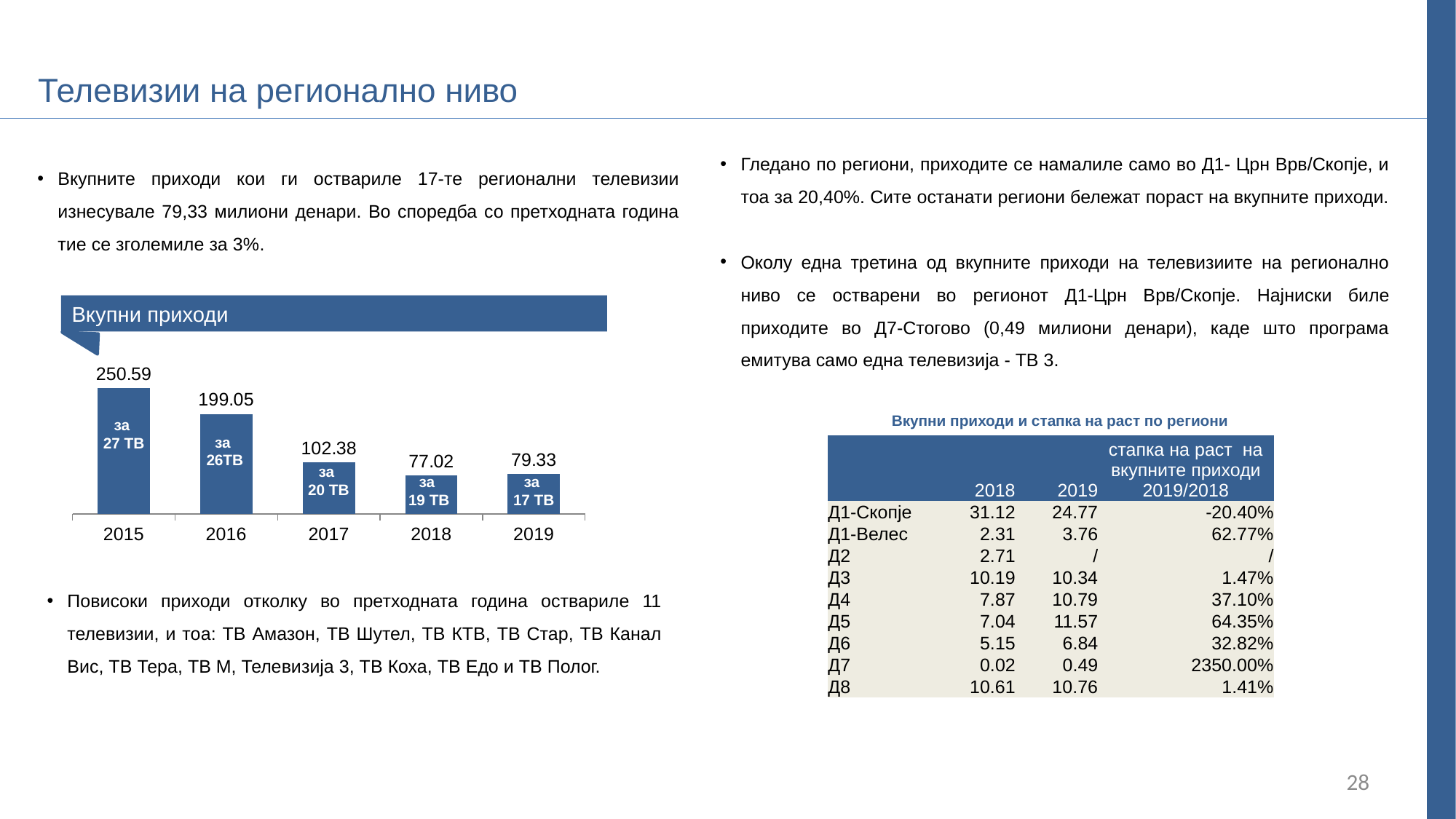
What is the value for 2017 in the 'Вкупни приходи' chart? 102.38 Which year has the highest value in the 'Вкупни приходи' chart? 2015 What is the value for 2015 in the 'Вкупни приходи' chart? 250.59 Do the values in the 'Вкупни приходи' chart generally rise or fall from 2015 to 2018? fall What is the difference between the 2019 and 2018 values in the 'Вкупни приходи' chart? 2.31 In the 'Вкупни приходи' chart, which is larger, the value for 2016 or the value for 2017? 2016 What is the difference between the 2015 and 2016 values in the 'Вкупни приходи' chart? 51.54 According to the label inside the 2019 bar of the 'Вкупни приходи' chart, how many TV stations does the value cover? 17 ТВ What is the value for 2019 in the 'Вкупни приходи' chart? 79.33 What kind of chart is the 'Вкупни приходи' chart? bar chart Which year has the lowest value in the 'Вкупни приходи' chart? 2018 How many years are shown in the 'Вкупни приходи' chart? 5